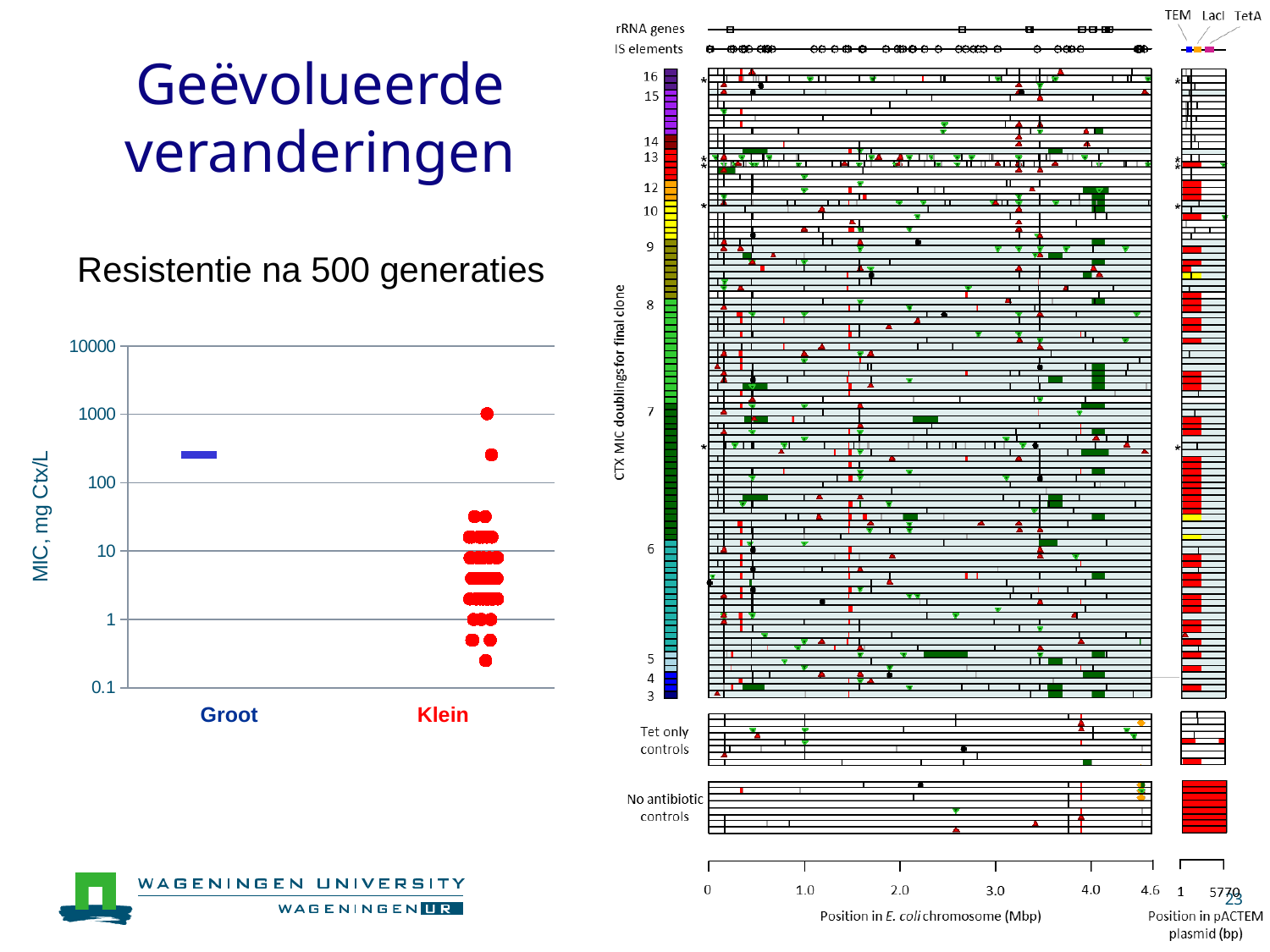
In the chart 'Resistentie na 500 generaties', is the value for Groot greater or less than 1000? less In the chart 'Resistentie na 500 generaties', is the lowest value for Klein greater or less than 1? less What is the title of the chart on the left side of the slide? Resistentie na 500 generaties What kind of chart is 'Resistentie na 500 generaties'? scatter (dot) plot In the chart 'Resistentie na 500 generaties', what is the label of the y axis? MIC, mg Ctx/L In the chart 'Resistentie na 500 generaties', which category has the lowest plotted value, Groot or Klein? Klein In the chart 'Resistentie na 500 generaties', is the lowest value for Klein greater or less than 0.1? greater How many categories are shown on the x axis of the chart 'Resistentie na 500 generaties'? 2 What are the two categories on the x axis of the chart 'Resistentie na 500 generaties'? Groot and Klein